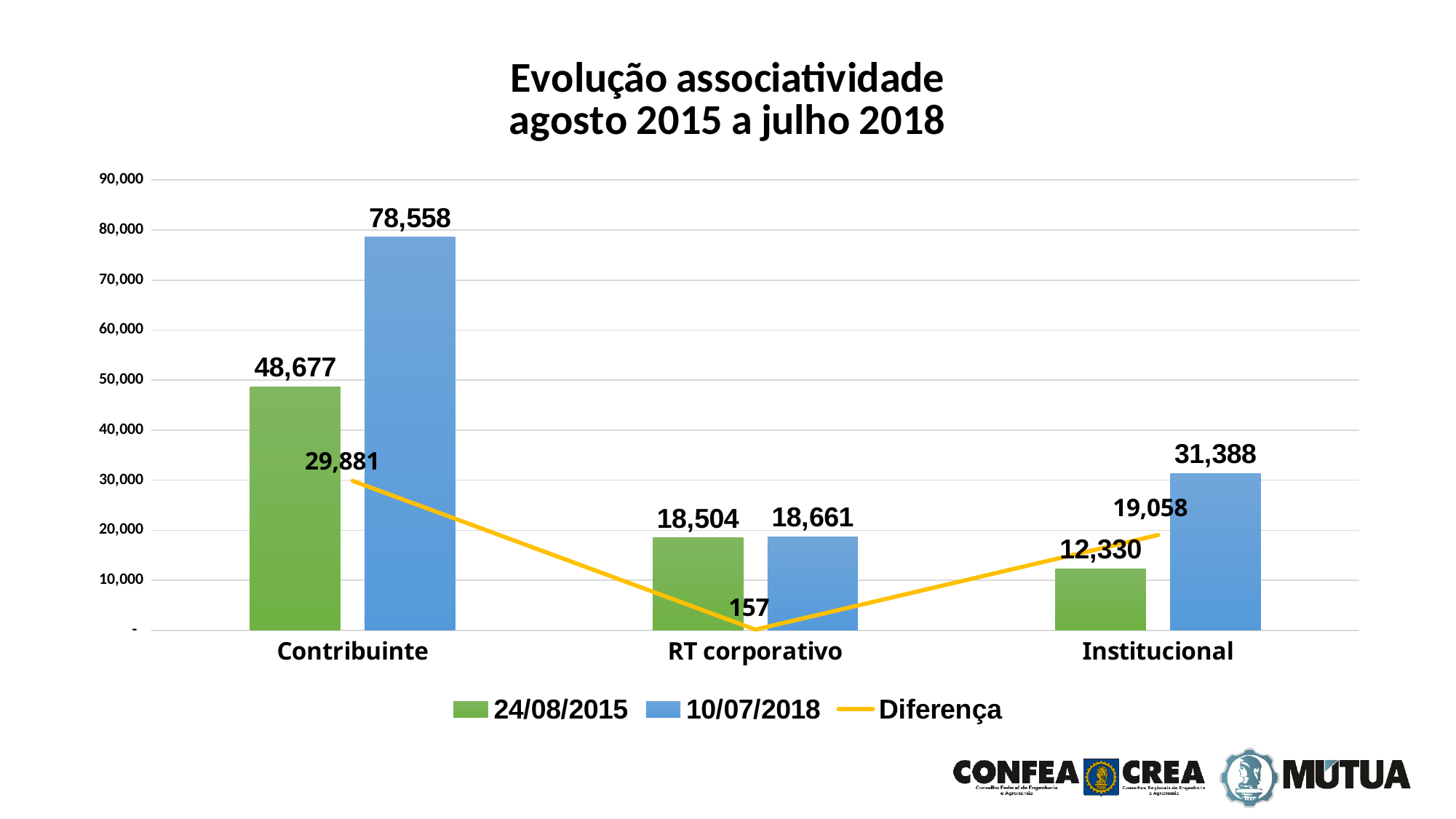
Which is larger for RT corporativo: the 24/08/2015 value or the 10/07/2018 value? 10/07/2018 Is the 10/07/2018 value for Institucional greater or less than 30,000? greater How many categories are shown on the x axis? 3 What is the Diferença value for RT corporativo? 157 What is the title of the chart? Evolução associatividade agosto 2015 a julho 2018 Which category has the highest value in the 10/07/2018 series? Contribuinte Which category has the lowest value in the 24/08/2015 series? Institucional What is the value for Institucional in the 24/08/2015 series? 12,330 How many series does the legend list? 3 What is the difference between the 10/07/2018 and 24/08/2015 values for Contribuinte? 29,881 What is the Diferença value for Institucional? 19,058 What is the value for Contribuinte in the 10/07/2018 series? 78,558